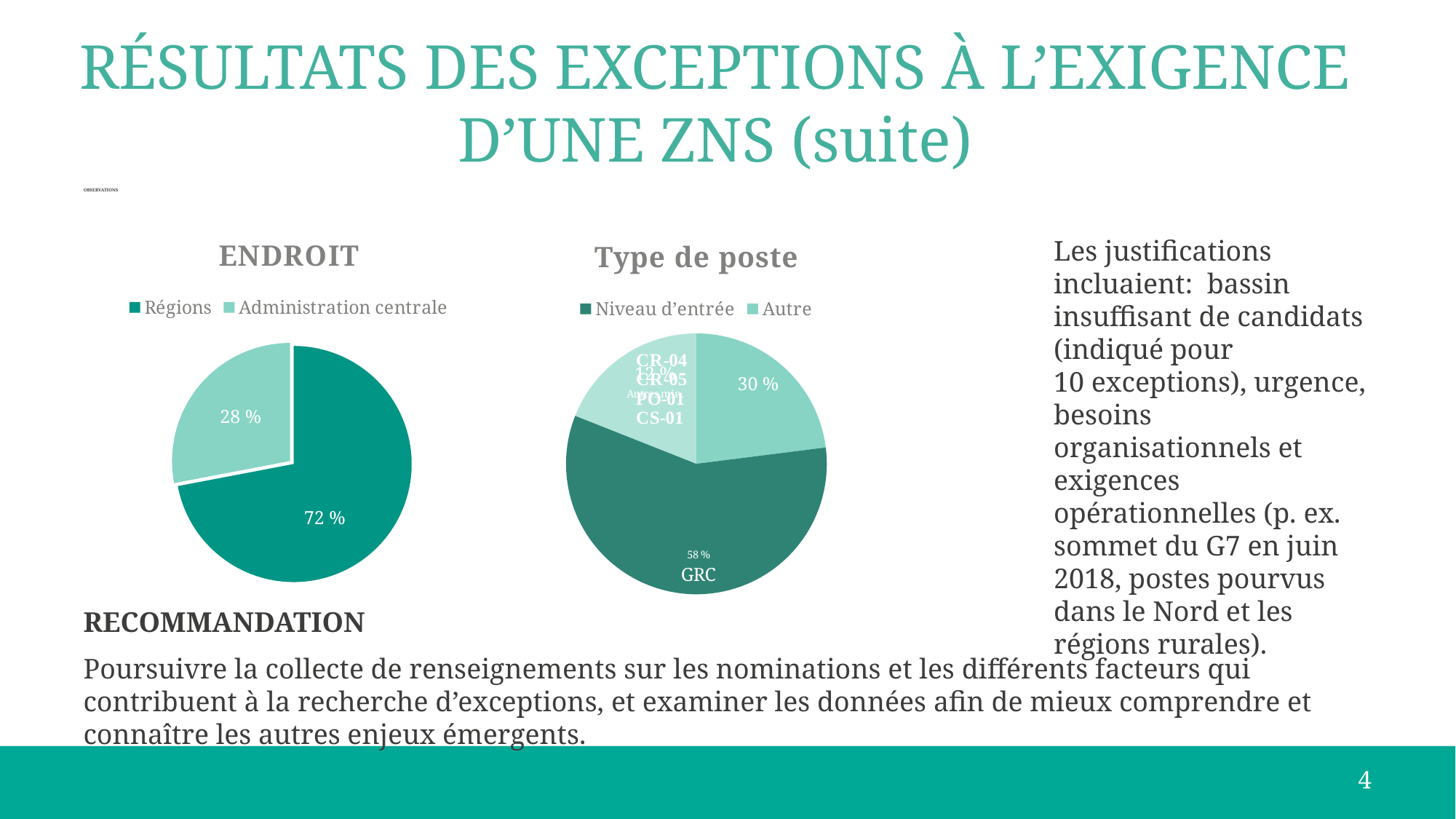
In the Type de poste chart, what percentage is shown on the largest light-coloured slice? 30 % In the ENDROIT chart, what percentage is shown for Administration centrale? 28 % What kind of chart is the ENDROIT chart? Pie chart In the ENDROIT chart, what percentage is shown for Régions? 72 % In the Type de poste chart, which slice is the largest? GRC In the ENDROIT chart, which category has the larger share? Régions In the ENDROIT chart, what is the difference in percentage points between Régions and Administration centrale? 44 What is the title of the chart on the left? ENDROIT In the ENDROIT chart, which category has the smaller share? Administration centrale In the Type de poste chart, what percentage is shown for the GRC slice? 58 % How many slices does the Type de poste pie chart have? 3 How many legend entries does the ENDROIT chart list? 2